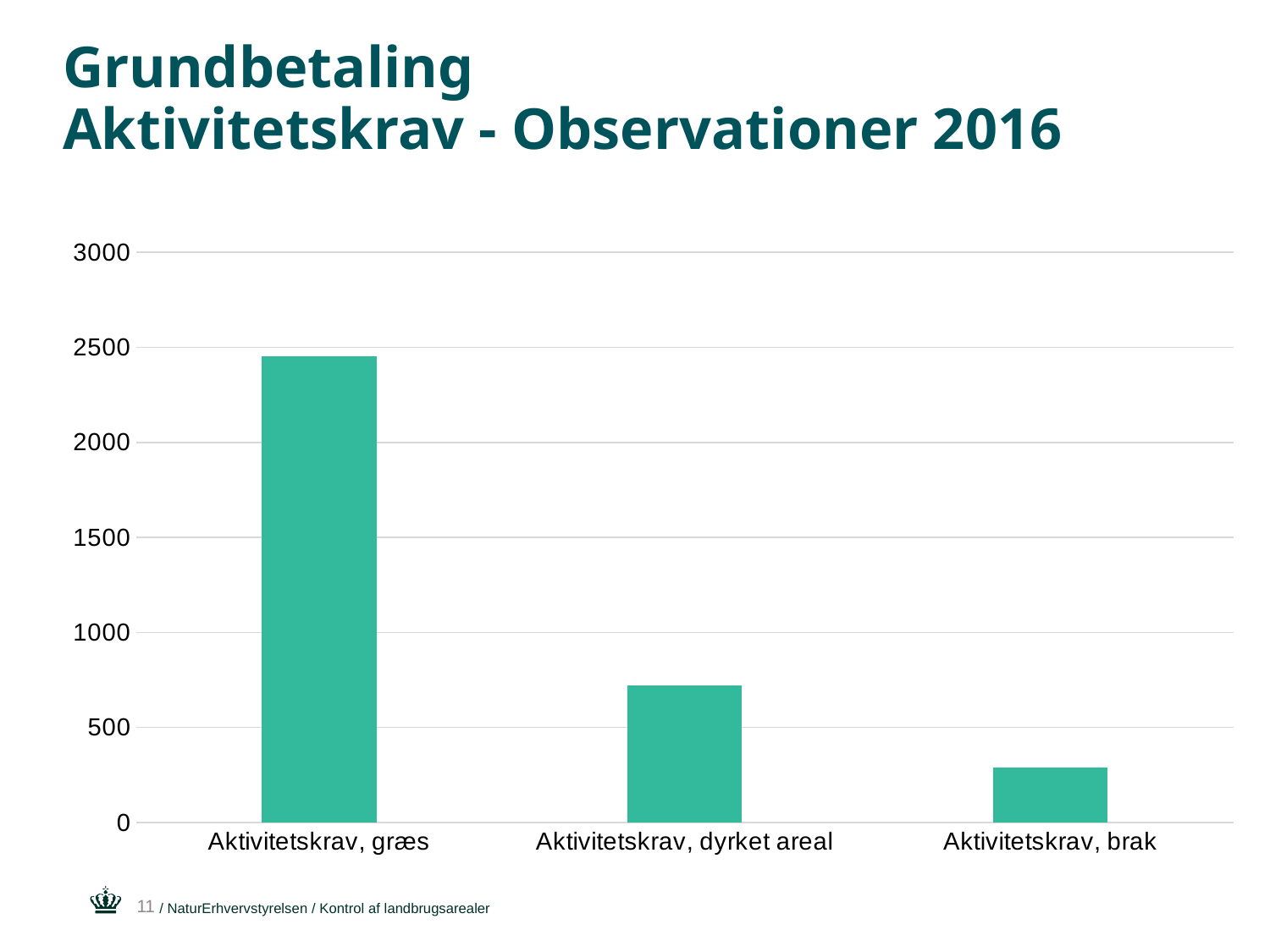
Which category has the highest value in the chart? Aktivitetskrav, græs How many categories are shown on the x axis of the chart? 3 Which is larger, the value for Aktivitetskrav, dyrket areal or the value for Aktivitetskrav, brak? Aktivitetskrav, dyrket areal What is the highest value shown on the y axis of the chart? 3000 Is the value for Aktivitetskrav, græs greater or less than 2000? greater Is the value for Aktivitetskrav, dyrket areal greater or less than 500? greater Is the value for Aktivitetskrav, dyrket areal greater or less than 1000? less Which category has the lowest value in the chart? Aktivitetskrav, brak What is the title of the slide containing the chart? Grundbetaling Aktivitetskrav - Observationer 2016 Do the bar values rise or fall from left to right along the x axis? fall What kind of chart is shown on the slide? bar chart